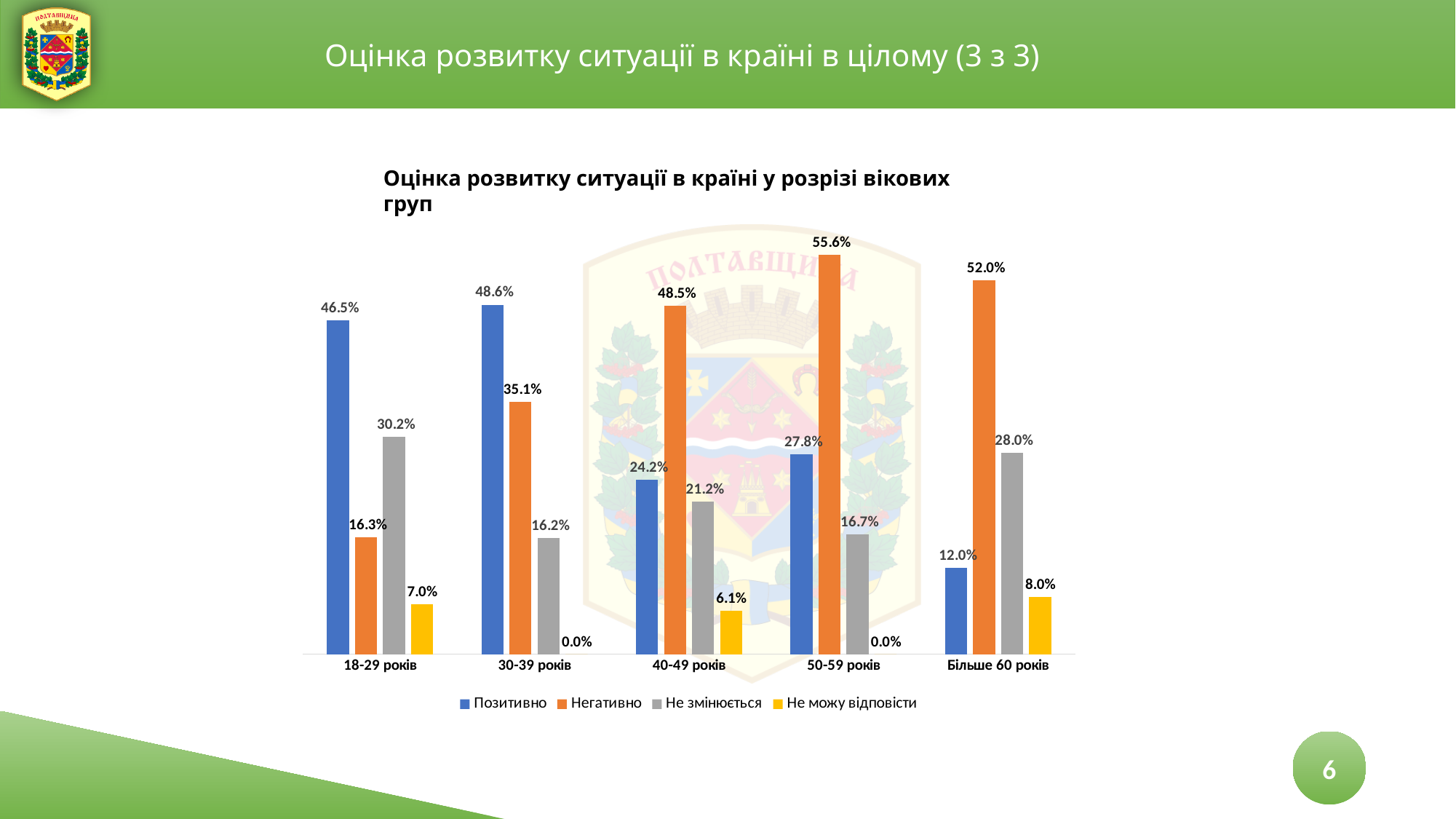
What is the value for Не змінюється in the Більше 60 років group? 28.0% What kind of chart is shown on the slide? Bar chart How many series does the legend list? 4 What is the difference between Позитивно and Негативно in the 30-39 років group? 13.5% How many age groups are shown on the x axis? 5 What is the value for Не можу відповісти in the 40-49 років group? 6.1% What is the value for Позитивно in the 18-29 років group? 46.5% In the 40-49 років group, which is larger: Позитивно or Негативно? Негативно Does the value for Негативно rise or fall from the 18-29 років group to the 50-59 років group? Rise Which age group has the highest value for Негативно? 50-59 років What is the value for Негативно in the 50-59 років group? 55.6% Which age group has the lowest value for Позитивно? Більше 60 років